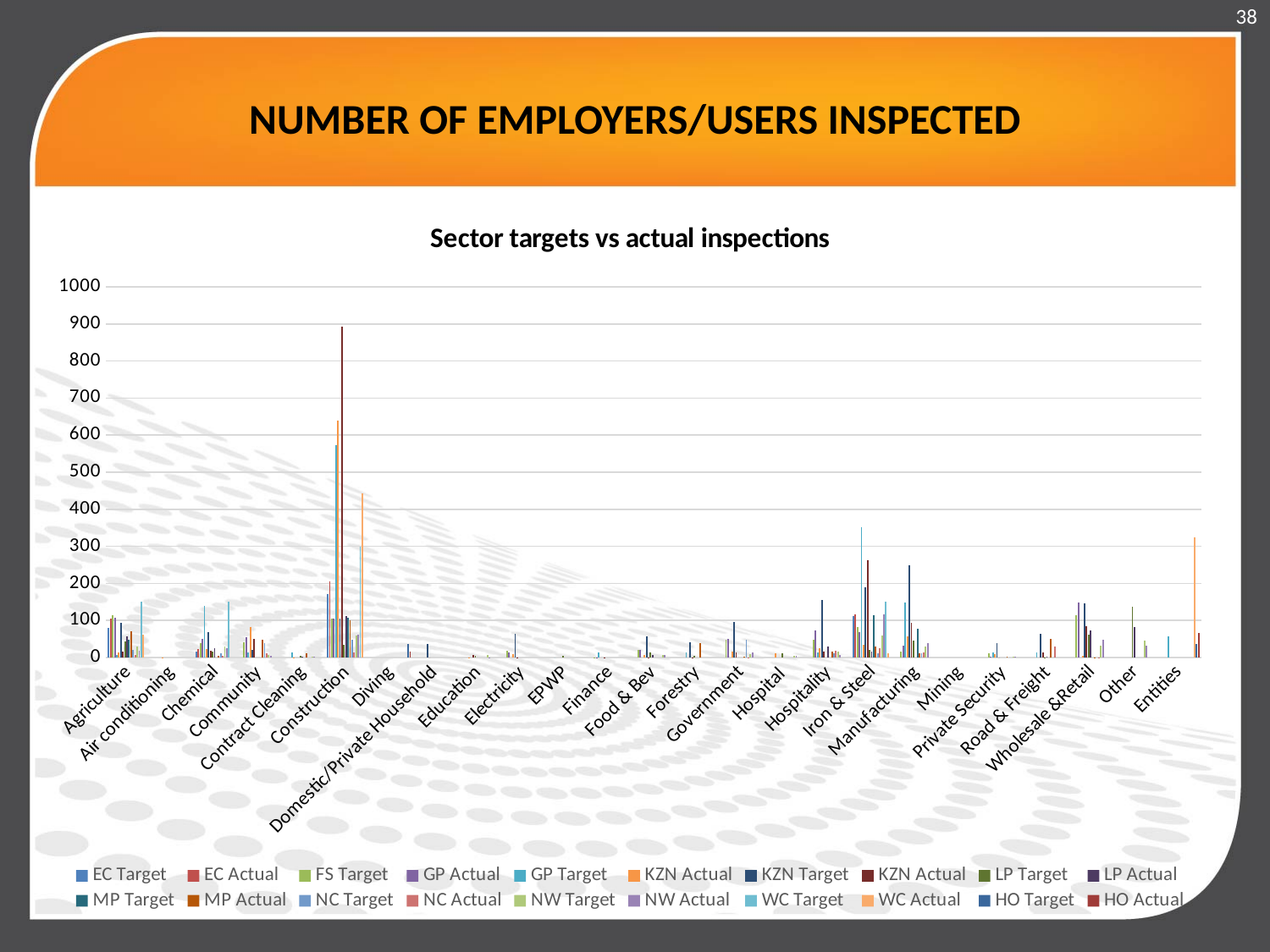
Which sector has the tallest bar in the chart? Construction Is the tallest bar for Iron & Steel greater or less than 300? greater How many sector categories are shown along the x axis of the chart? 25 Is the tallest bar for Manufacturing greater or less than 200? greater Which sector has a taller maximum bar, Construction or Iron & Steel? Construction What is the highest value shown on the chart's vertical axis? 1000 What is the title of the chart? Sector targets vs actual inspections Is the tallest bar for Agriculture greater or less than 200? less How many series does the chart legend list? 20 What kind of chart is shown on the slide? Bar chart